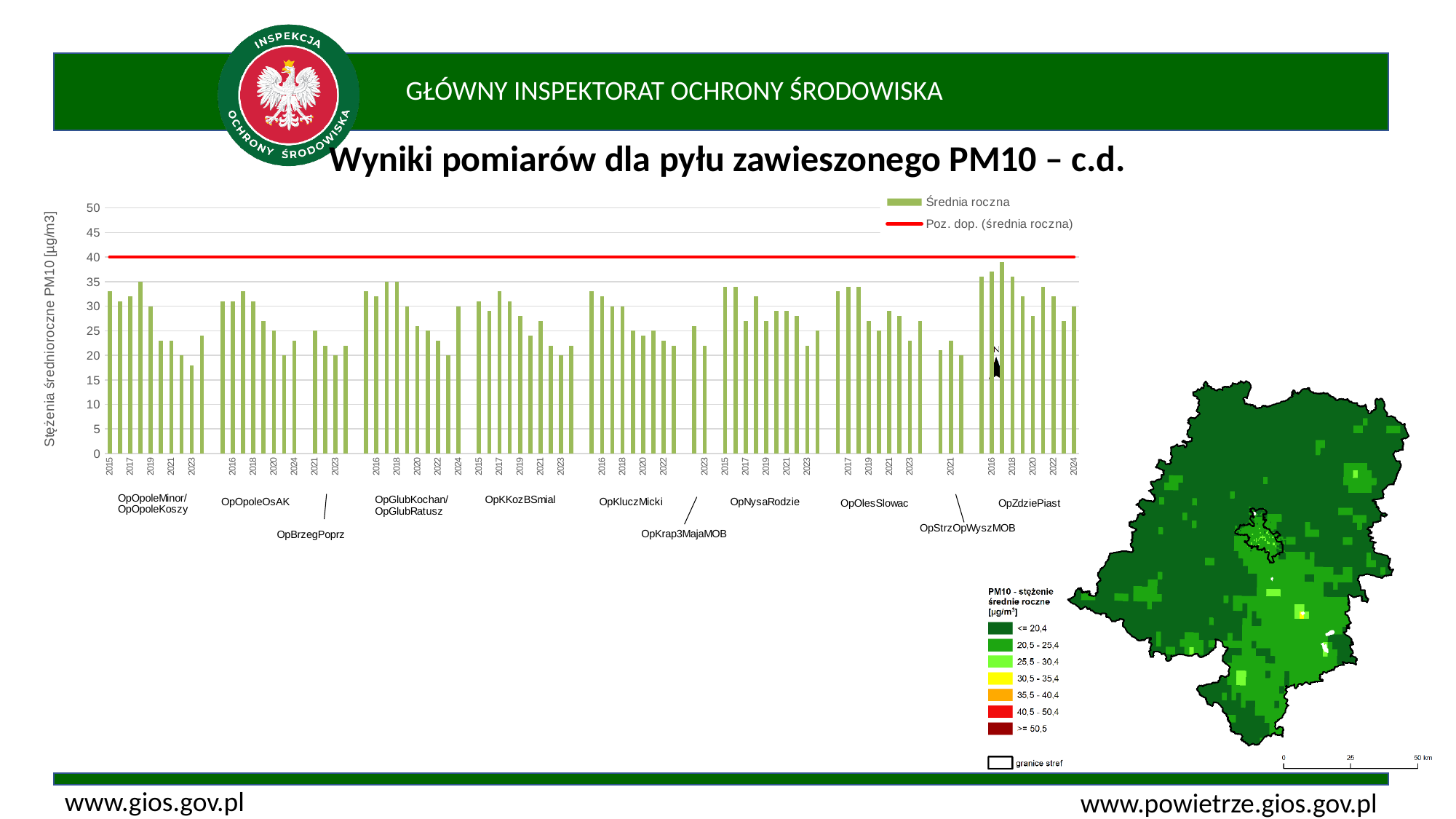
Is the tallest bar for OpZdziePiast greater or less than 40? less At what value is the red 'Poz. dop. (średnia roczna)' line drawn? 40 Do any of the annual average bars exceed the red permissible level line? No What is the label of the chart's vertical axis? Stężenia średnioroczne PM10 [µg/m3] What kind of chart is shown on the slide? bar chart Which station has the tallest annual average bar on the chart? OpZdziePiast How many series does the chart legend list? 2 Do the bars for OpOpoleMinor/OpOpoleKoszy generally rise or fall from 2015 to 2023? fall Which station has a taller maximum bar, OpZdziePiast or OpBrzegPoprz? OpZdziePiast Is the first (2015) bar for OpOpoleMinor/OpOpoleKoszy greater or less than 30? greater Are all the bars for OpBrzegPoprz greater or less than 30? less